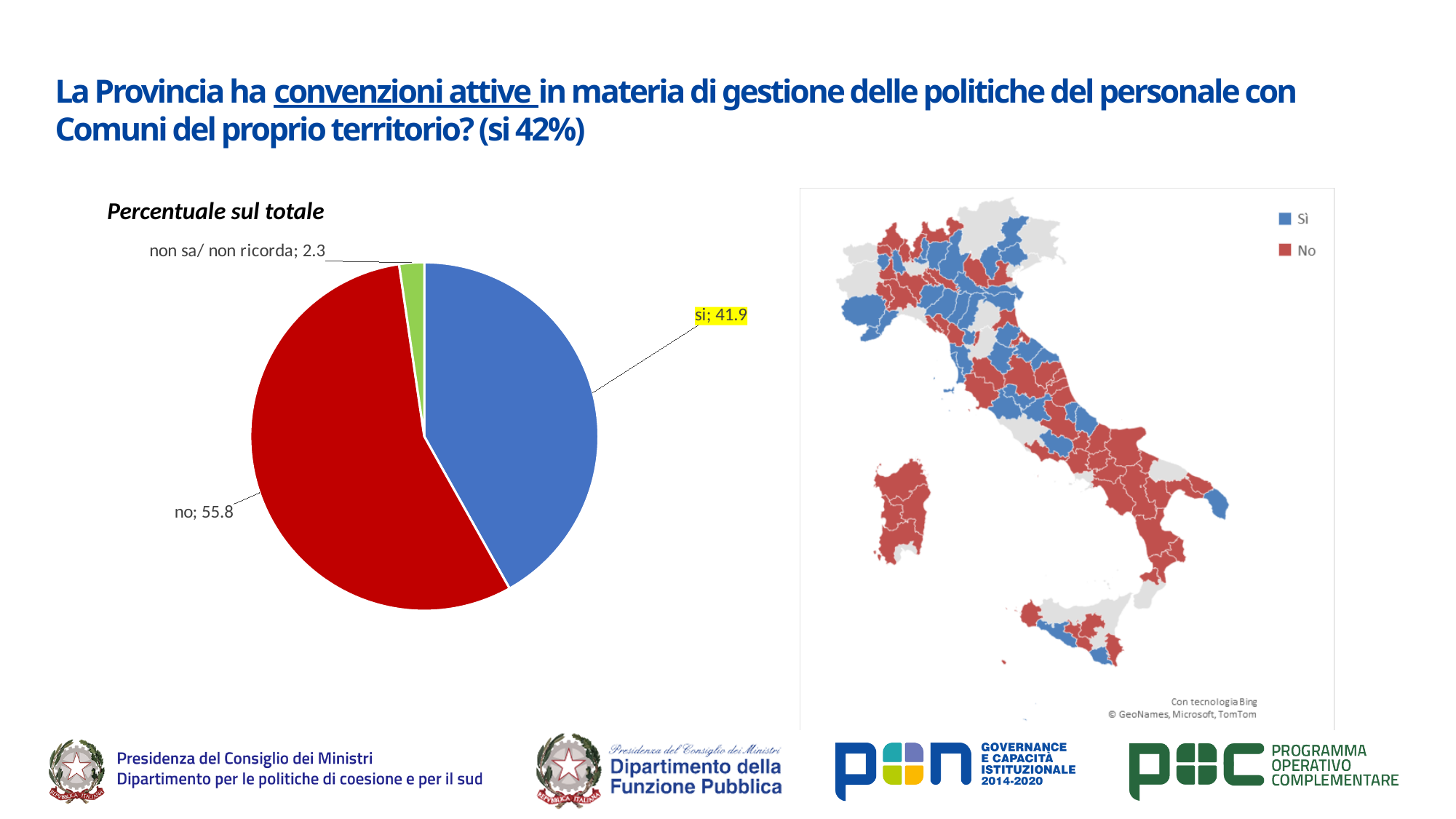
In the pie chart 'Percentuale sul totale', what is the value for 'si'? 41.9 In the pie chart 'Percentuale sul totale', which category has the smallest slice? non sa/ non ricorda How many entries does the legend of the map on the right list? 2 In the pie chart 'Percentuale sul totale', what is the value for 'no'? 55.8 In the pie chart 'Percentuale sul totale', what is the value for 'non sa/ non ricorda'? 2.3 In the map on the right, what colour represents 'Sì'? blue In the pie chart 'Percentuale sul totale', which is larger, 'si' or 'no'? no How many slices does the pie chart 'Percentuale sul totale' have? 3 In the pie chart 'Percentuale sul totale', what is the difference between the 'no' and 'si' values? 13.9 In the pie chart 'Percentuale sul totale', what colour is the 'no' slice? red In the pie chart 'Percentuale sul totale', which category has the largest slice? no What kind of chart is the chart titled 'Percentuale sul totale'? pie chart